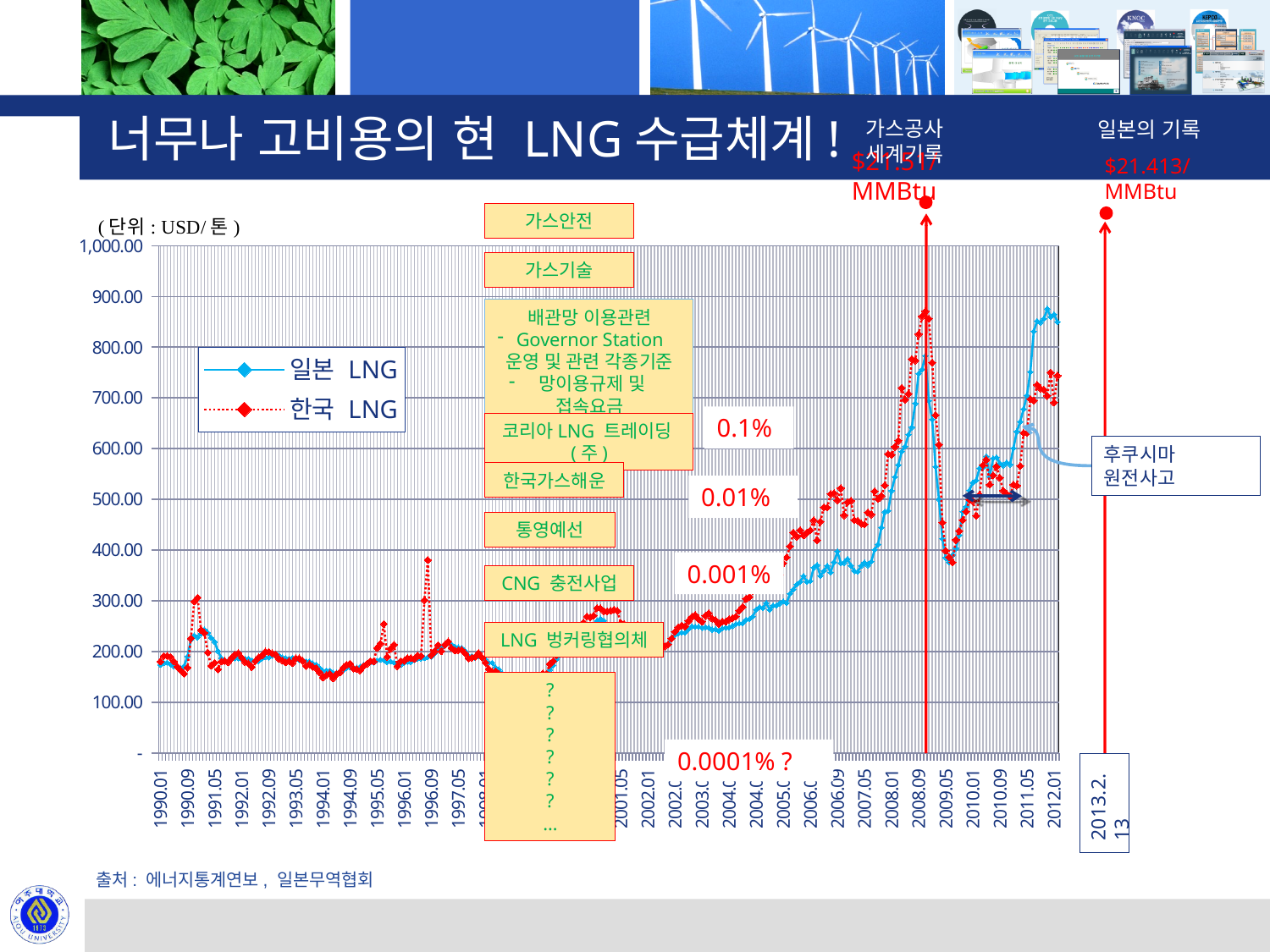
What are the two series named in the chart's legend? 일본 LNG, 한국 LNG Is the value for 한국 LNG at its low point around 2009.05 greater or less than 500? less How many series does the chart's legend list? 2 What is the highest value shown on the chart's vertical axis? 1,000.00 Is the value for 한국 LNG at its spike around 1996.09 greater or less than 300? greater Is the value for 일본 LNG at 1990.01 greater or less than 300? less Overall, do the LNG price values rise or fall from 1990.01 to 2012.01? rise Which series reaches a higher value around 2008.09, 일본 LNG or 한국 LNG? 한국 LNG What unit is stated for the chart's values? USD/톤 What kind of chart is shown on the slide? line chart